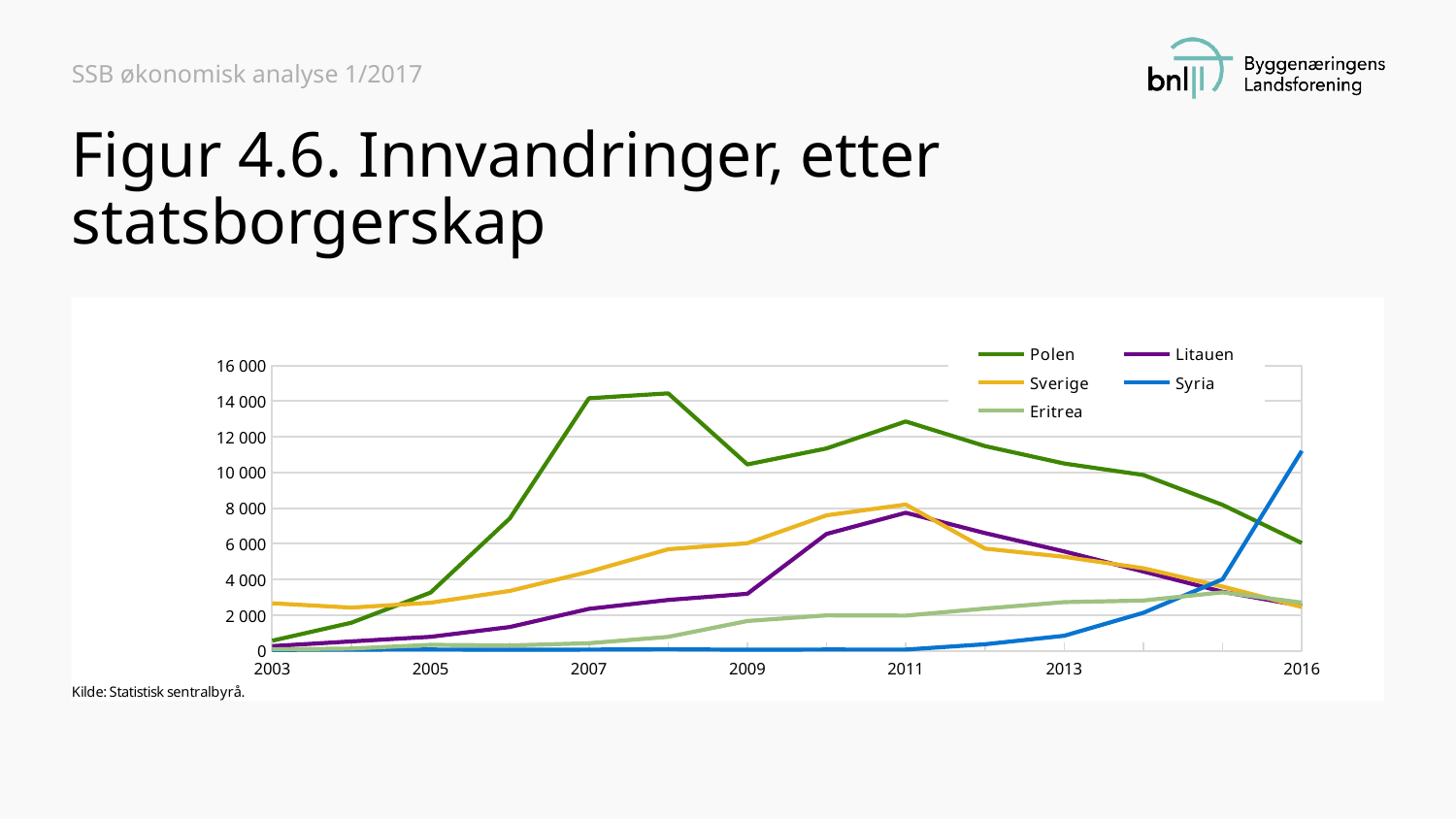
What source is cited below the chart? Statistisk sentralbyrå What kind of chart is shown on the slide? line chart Which series has the highest value in 2016? Syria Is the value for Polen in 2007 greater or less than 12 000? greater Is the value for Syria in 2016 greater or less than 10 000? greater Is the value for Eritrea in 2013 greater or less than 4 000? less Does the value for Syria rise or fall from 2013 to 2016? rise Which series has the lowest value in 2009? Syria In 2012, which is higher, Sverige or Litauen? Litauen Which series has the highest value in 2008? Polen How many series does the legend list? 5